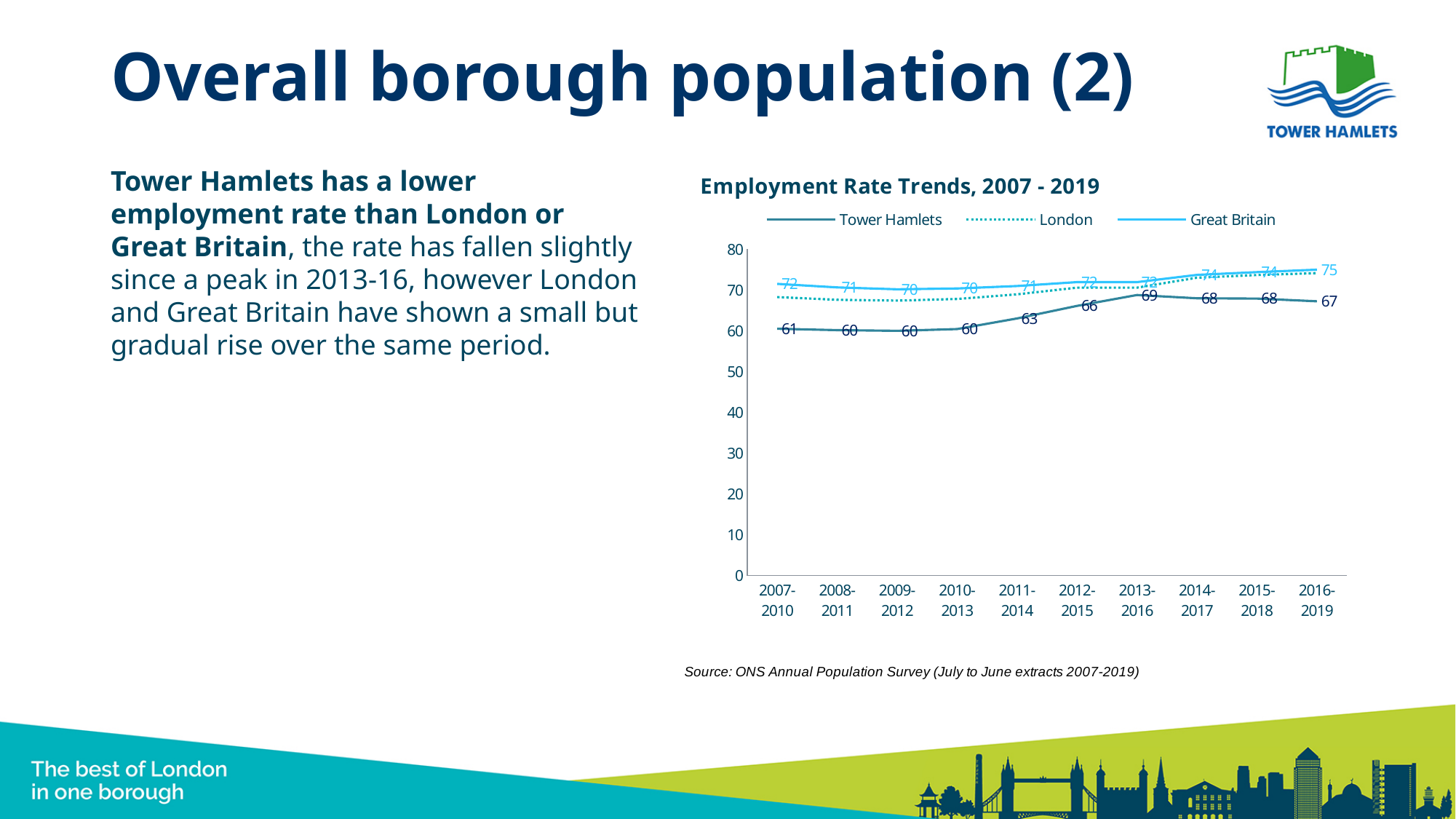
What type of chart is shown on the slide? Line chart What is the Great Britain employment rate for 2016-2019? 75 How many series does the legend of the Employment Rate Trends chart list? 3 What is the Great Britain employment rate for 2007-2010? 72 In which period does the Tower Hamlets series reach its highest value? 2013-2016 How many time periods are plotted along the x axis of the Employment Rate Trends chart? 10 Does the Tower Hamlets series rise or fall between 2010-2013 and 2013-2016? Rise What is the Tower Hamlets employment rate for 2007-2010? 61 What is the Tower Hamlets employment rate for 2013-2016? 69 What is the difference between the Great Britain and Tower Hamlets employment rates in 2016-2019? 8 Which is larger in 2007-2010, the Tower Hamlets rate or the Great Britain rate? Great Britain In which period does the Great Britain series reach its highest value? 2016-2019